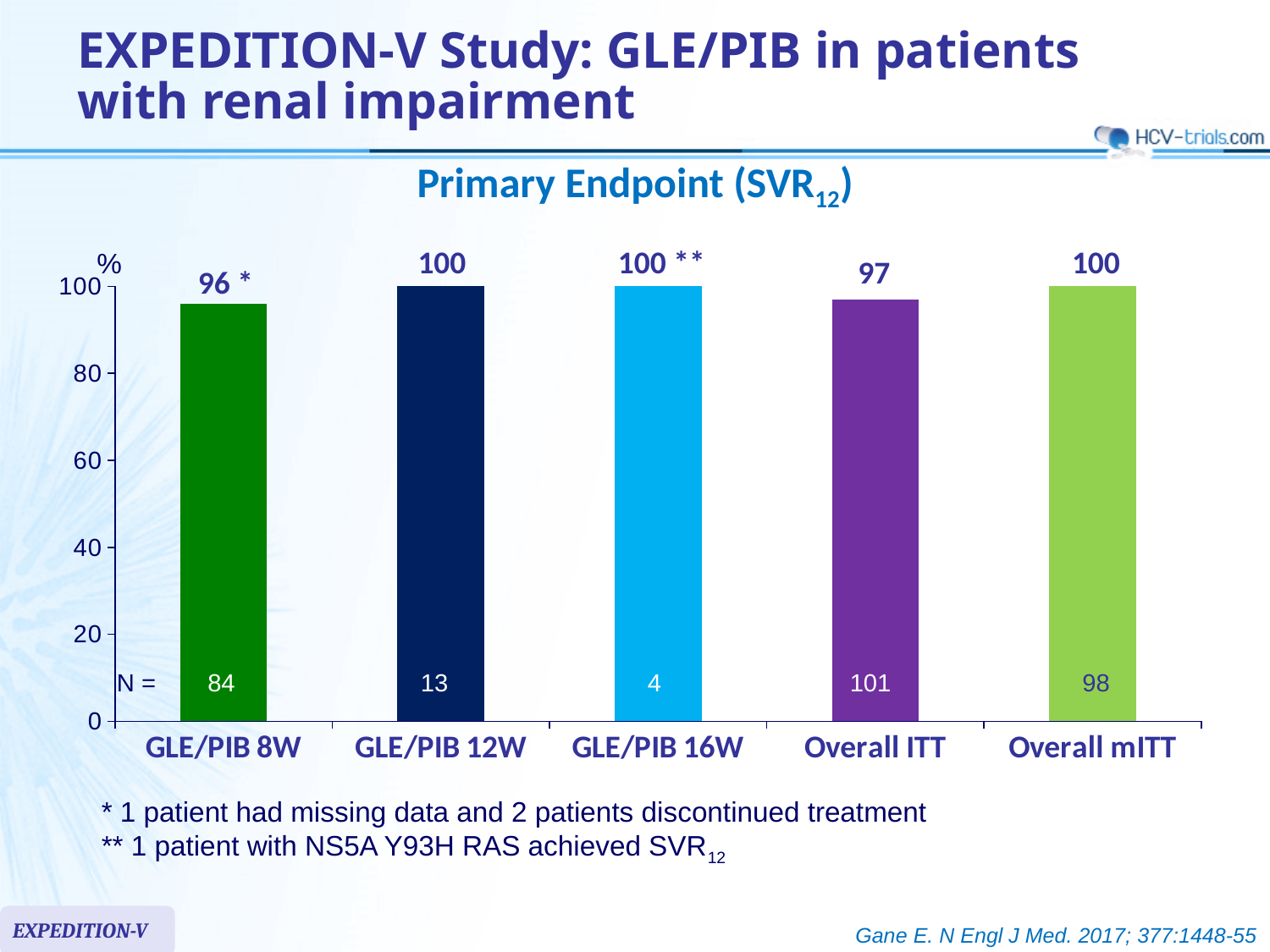
What is the N for the GLE/PIB 16W group? 4 Which category has the lowest SVR12 rate? GLE/PIB 8W What is the SVR12 rate for Overall ITT? 97 What is the difference in N between GLE/PIB 8W and GLE/PIB 12W? 71 What is the SVR12 rate for GLE/PIB 8W? 96 What is the difference in SVR12 rate between Overall mITT and Overall ITT? 3 What kind of chart is shown on the slide? Bar chart Which has a higher SVR12 rate, GLE/PIB 8W or GLE/PIB 12W? GLE/PIB 12W What is the N for the Overall ITT group? 101 What is the title of the chart? Primary Endpoint (SVR12) What is the SVR12 rate for GLE/PIB 12W? 100 How many categories are shown on the x axis? 5